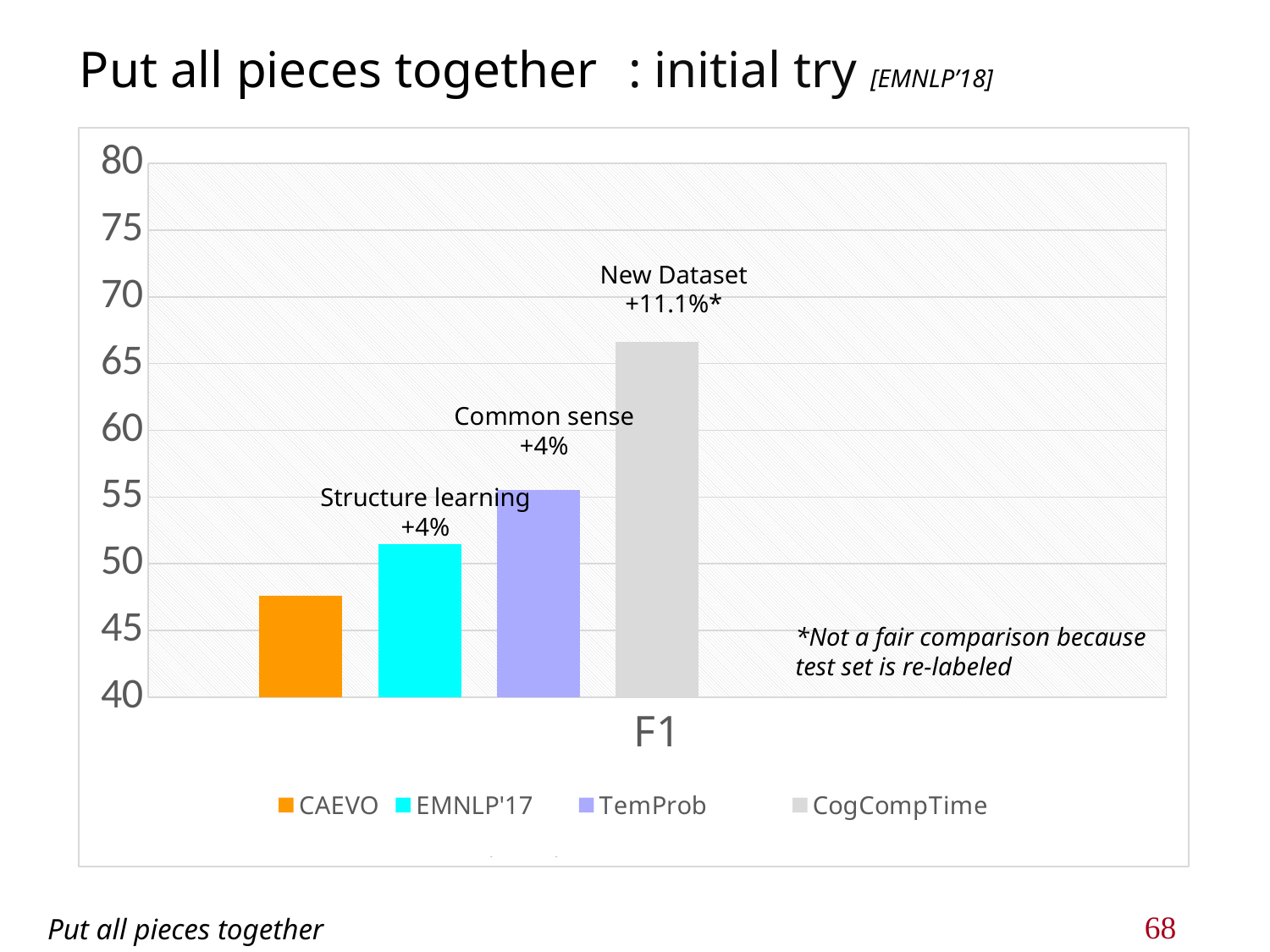
What improvement is annotated above the CogCompTime bar for the New Dataset? +11.1%* Which is larger, the F1 bar for TemProb or for EMNLP'17? TemProb Is the F1 value for TemProb greater or less than 60? less Is the F1 value for CogCompTime greater or less than 65? greater What kind of chart is shown on the slide? bar chart How many categories are shown on the x axis? 1 Is the F1 value for EMNLP'17 greater or less than 50? greater Which series has the highest F1 bar? CogCompTime Which series has the lowest F1 bar? CAEVO How many series does the legend list? 4 What is the label of the category on the x axis? F1